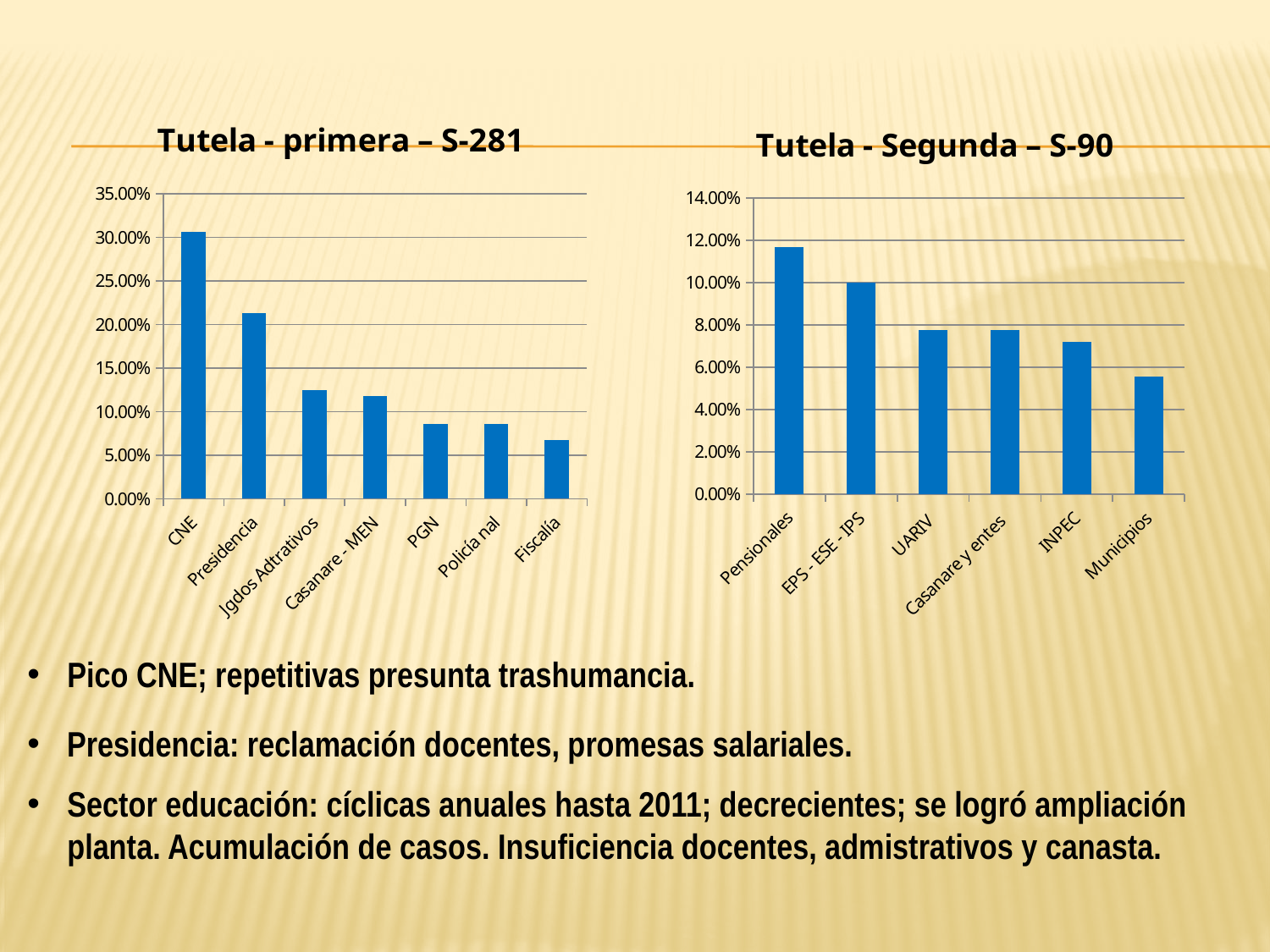
In the 'Tutela - primera – S-281' chart, which is larger, the value for Presidencia or the value for Jgdos Adtrativos? Presidencia In the 'Tutela - Segunda – S-90' chart, is the value for INPEC greater or less than 8.00%? less In the 'Tutela - Segunda – S-90' chart, which category has the lowest value? Municipios In the 'Tutela - Segunda – S-90' chart, do the values rise or fall from left to right across the categories? fall In the 'Tutela - primera – S-281' chart, is the value for Presidencia greater or less than 25.00%? less In the 'Tutela - Segunda – S-90' chart, which category has the highest value? Pensionales In the 'Tutela - primera – S-281' chart, which category has the highest value? CNE What kind of chart is the 'Tutela - primera – S-281' chart? bar chart How many categories are shown in the 'Tutela - Segunda – S-90' chart? 6 In the 'Tutela - primera – S-281' chart, is the value for CNE greater or less than 30.00%? greater In the 'Tutela - primera – S-281' chart, which category has the lowest value? Fiscalía How many categories are shown in the 'Tutela - primera – S-281' chart? 7